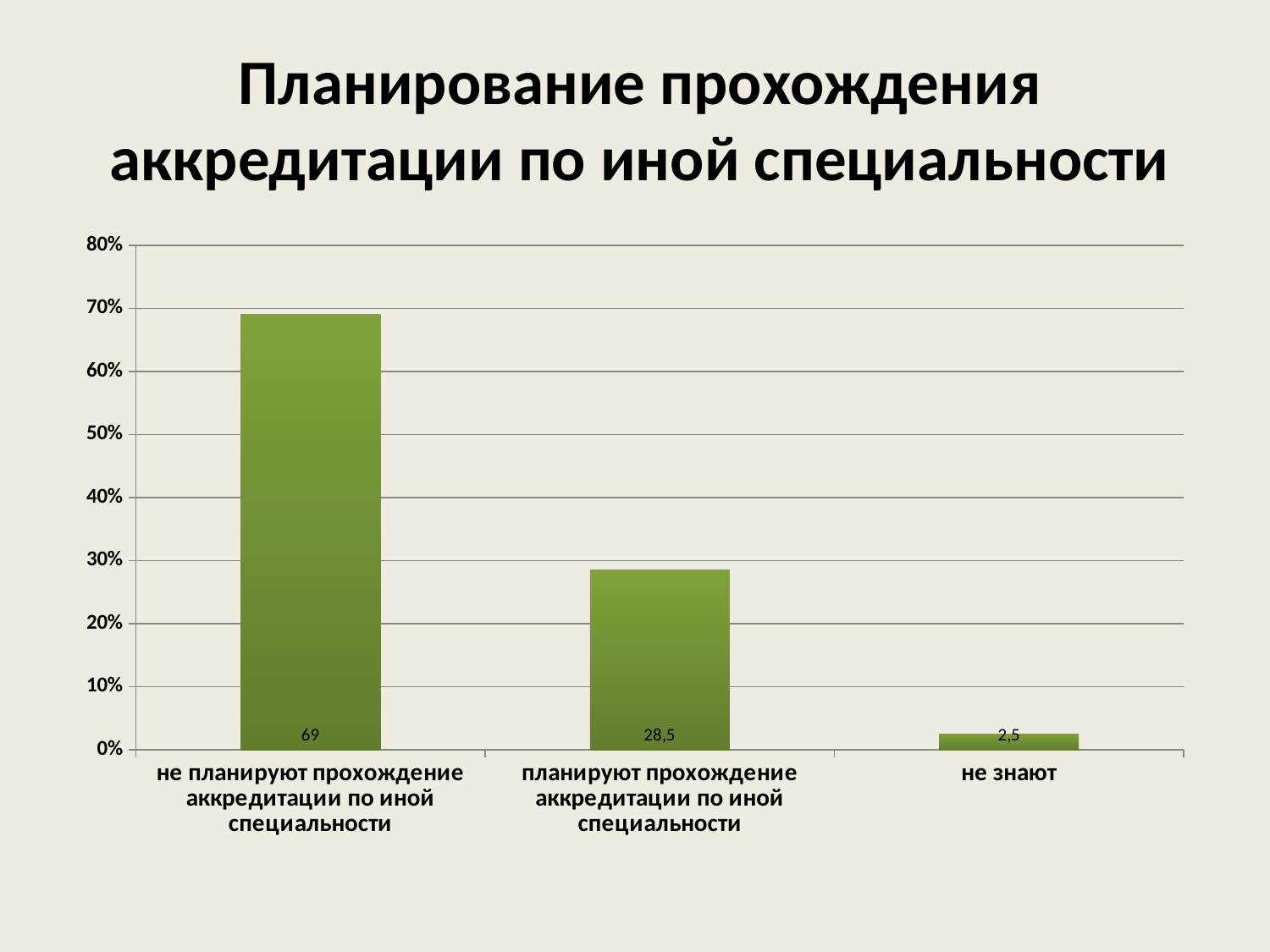
What is the value shown for the category "планируют прохождение аккредитации по иной специальности"? 28,5 Is the value for "планируют прохождение аккредитации по иной специальности" greater or less than 30%? less What is the difference between the values for "планируют прохождение аккредитации по иной специальности" and "не знают"? 26 What is the value shown for the category "не знают"? 2,5 How many categories are shown on the x axis? 3 What kind of chart is shown on the slide? bar chart What is the value shown for the category "не планируют прохождение аккредитации по иной специальности"? 69 What is the difference between the values for "не планируют прохождение аккредитации по иной специальности" and "планируют прохождение аккредитации по иной специальности"? 40,5 Which is larger: the value for "планируют прохождение аккредитации по иной специальности" or the value for "не знают"? планируют прохождение аккредитации по иной специальности Which category has the lowest value? не знают Which category has the highest value? не планируют прохождение аккредитации по иной специальности What is the title of the slide? Планирование прохождения аккредитации по иной специальности